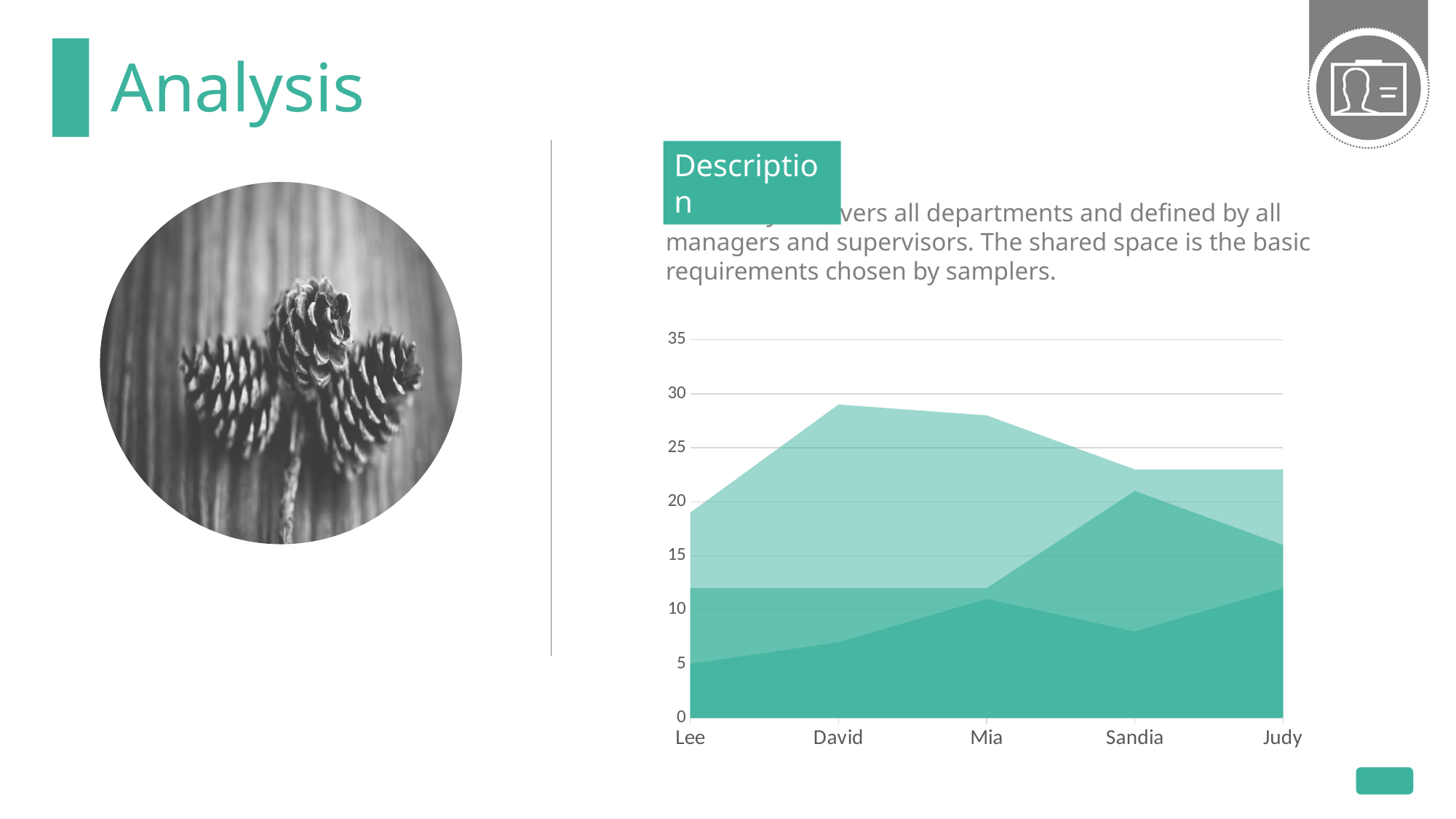
What kind of chart is shown on the slide? area chart What is the highest value shown on the chart's vertical axis? 35 Is the value of the bottom (darkest) series for Lee greater or less than 10? less How many categories are shown on the x axis of the chart? 5 What is the label of the first category on the x axis? Lee